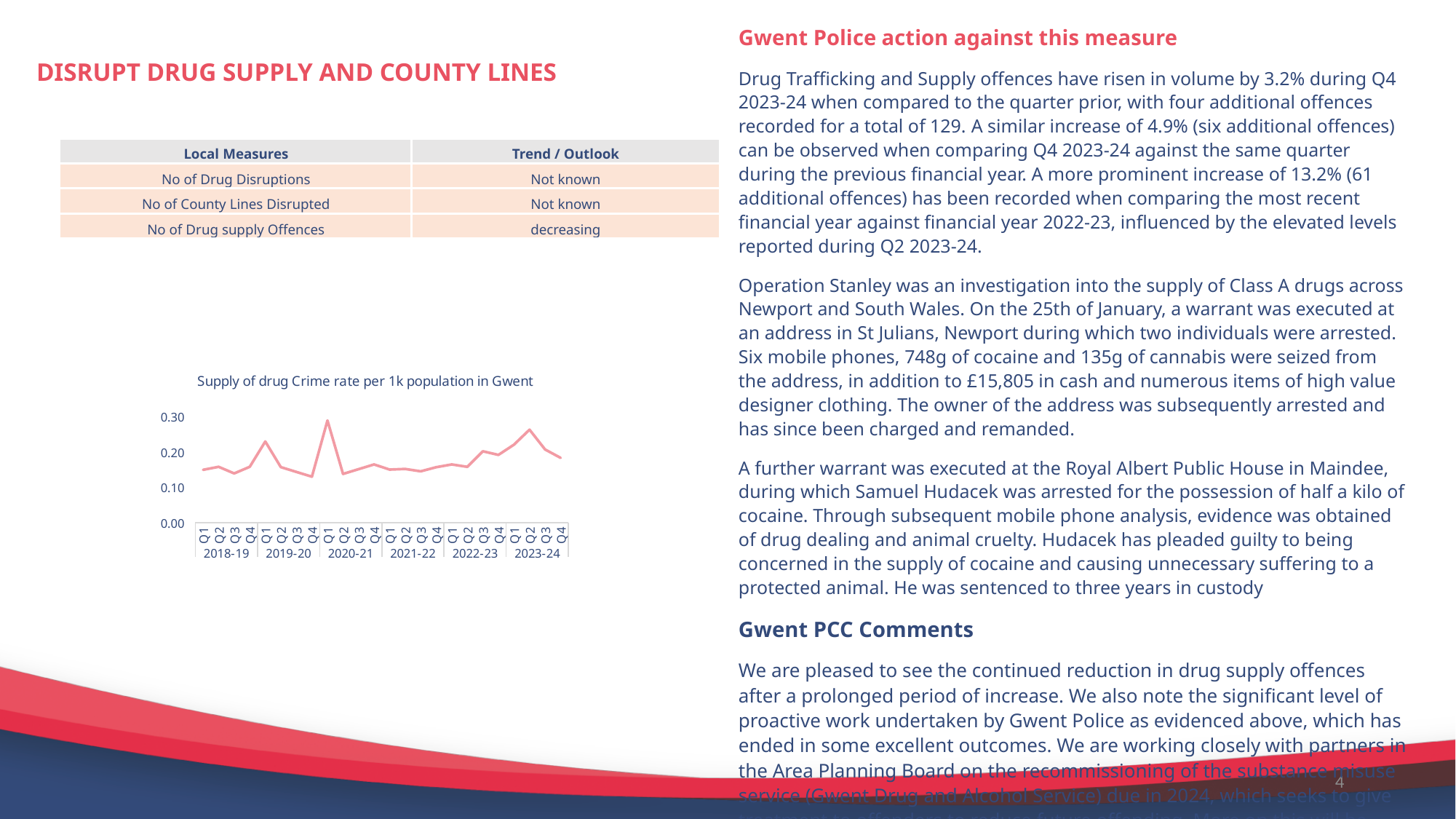
Which is larger, the value for Q1 2020-21 or the value for Q2 2023-24? Q1 2020-21 How many quarterly data points are plotted on the chart? 24 What is the title of the chart on the slide? Supply of drug Crime rate per 1k population in Gwent How many financial years are shown along the x axis of the chart? 6 Is the value for Q1 2019-20 greater or less than 0.20? greater What type of chart is shown on the slide? line chart Does the crime rate rise or fall between Q1 2022-23 and Q2 2023-24? rise Is the value for Q2 2023-24 greater or less than 0.20? greater Is the value for Q1 2018-19 greater or less than 0.20? less In which quarter does the supply of drug crime rate reach its highest point? Q1 2020-21 What is the highest value shown on the y axis of the chart? 0.30